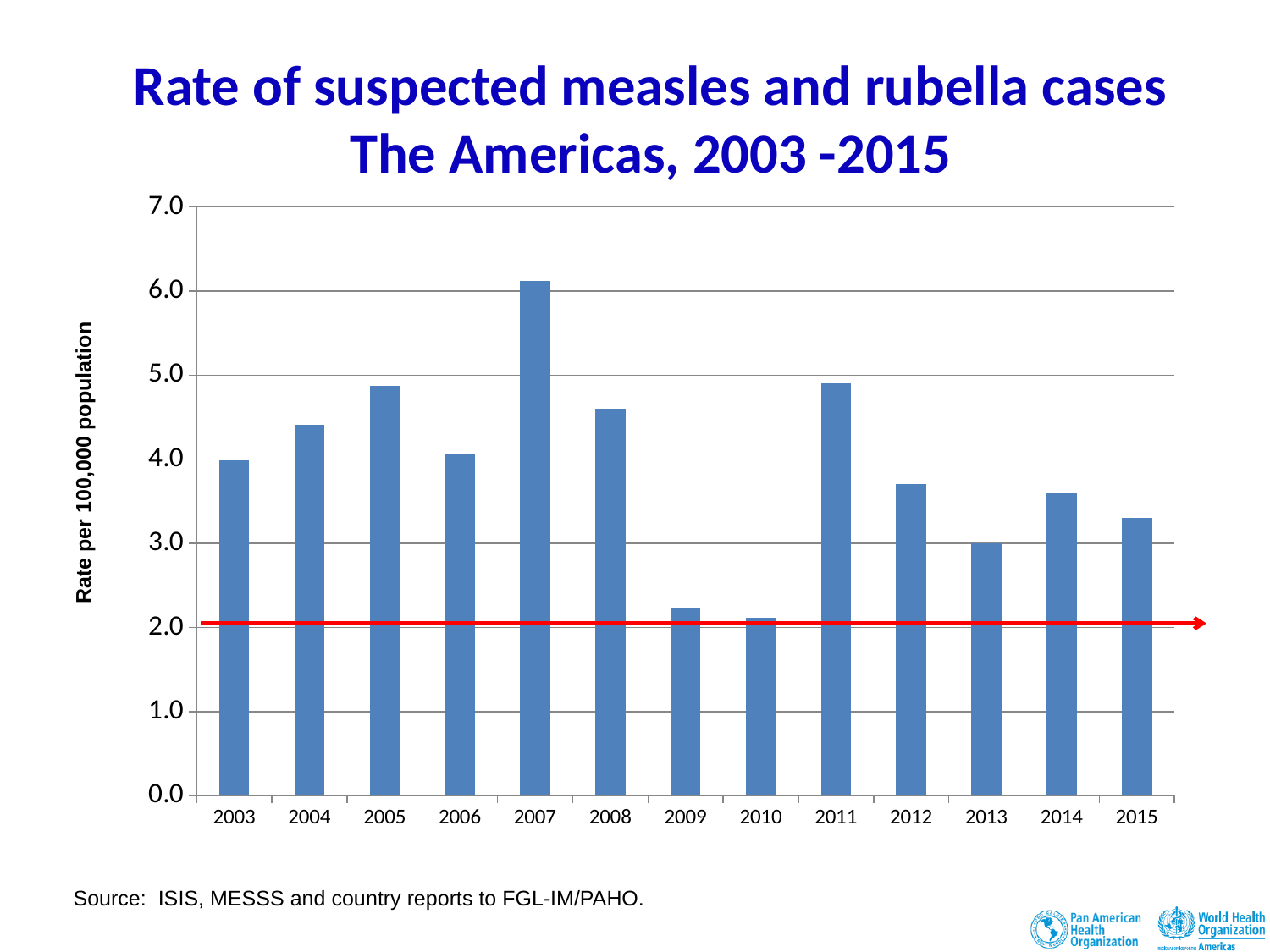
Is the value for 2007 greater or less than 5.0? greater What is the label on the vertical axis of the chart? Rate per 100,000 population Is the value for 2011 greater or less than 4.0? greater Which is larger, the value for 2007 or the value for 2011? 2007 Which is larger, the value for 2004 or the value for 2012? 2004 Do the values rise or fall from 2011 to 2013? fall What kind of chart is shown on the slide? bar chart Is the value for 2009 greater or less than 3.0? less Which year has the highest rate of suspected measles and rubella cases? 2007 How many years (bars) are plotted in the chart? 13